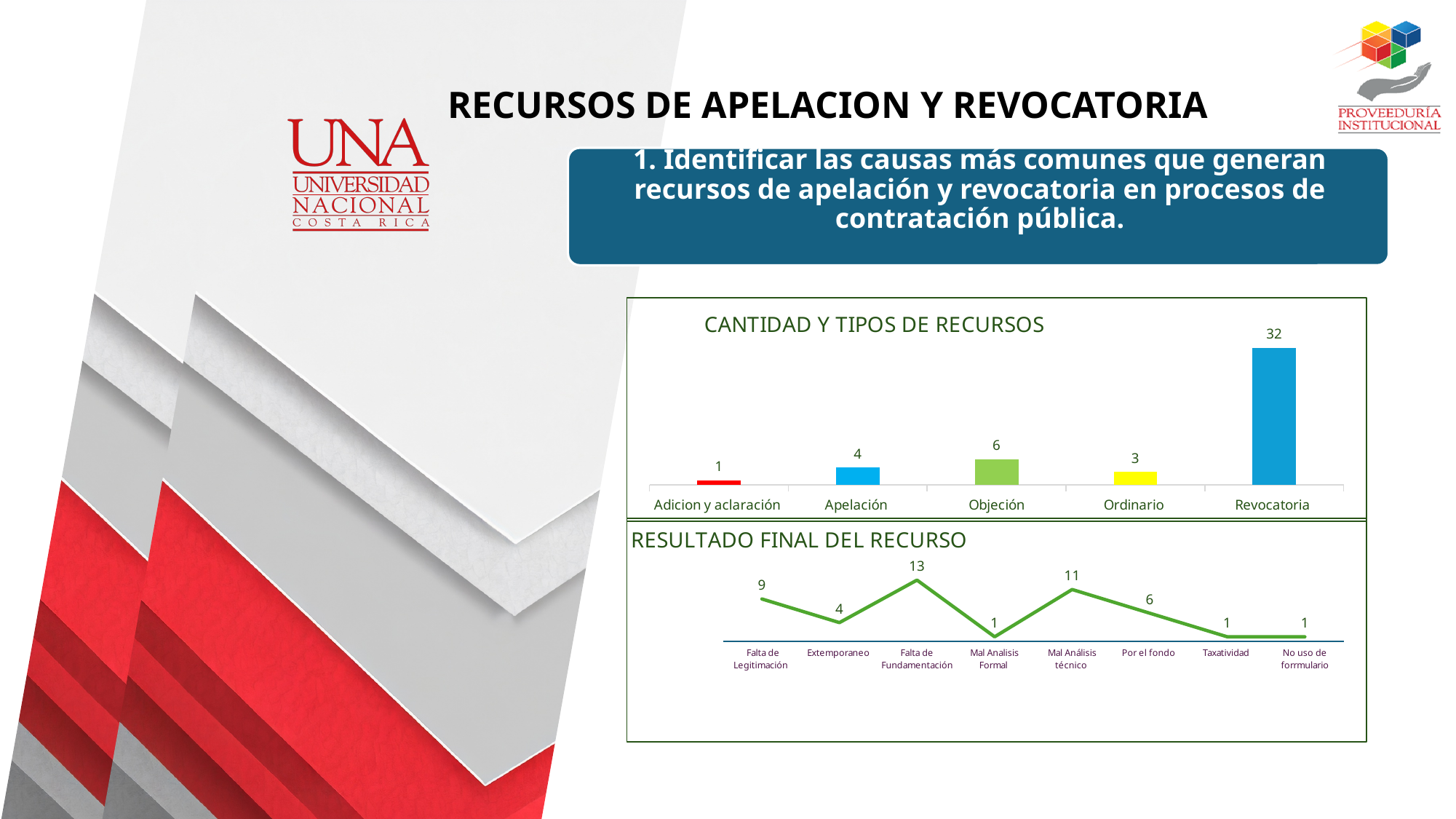
In the 'CANTIDAD Y TIPOS DE RECURSOS' chart, how many categories are shown? 5 In the 'CANTIDAD Y TIPOS DE RECURSOS' chart, which category has the lowest value? Adicion y aclaración In the 'RESULTADO FINAL DEL RECURSO' chart, is the value for Falta de Legitimación or Extemporaneo larger? Falta de Legitimación What type of chart is 'RESULTADO FINAL DEL RECURSO'? Line chart What type of chart is 'CANTIDAD Y TIPOS DE RECURSOS'? Bar chart In the 'RESULTADO FINAL DEL RECURSO' chart, what is the value for Falta de Fundamentación? 13 In the 'CANTIDAD Y TIPOS DE RECURSOS' chart, what is the difference between Revocatoria and Apelación? 28 In the 'CANTIDAD Y TIPOS DE RECURSOS' chart, which category has the highest value? Revocatoria In the 'RESULTADO FINAL DEL RECURSO' chart, which category has the highest value? Falta de Fundamentación In the 'RESULTADO FINAL DEL RECURSO' chart, what is the value for Mal Análisis técnico? 11 In the 'CANTIDAD Y TIPOS DE RECURSOS' chart, what is the value for Revocatoria? 32 In the 'CANTIDAD Y TIPOS DE RECURSOS' chart, what is the value for Objeción? 6